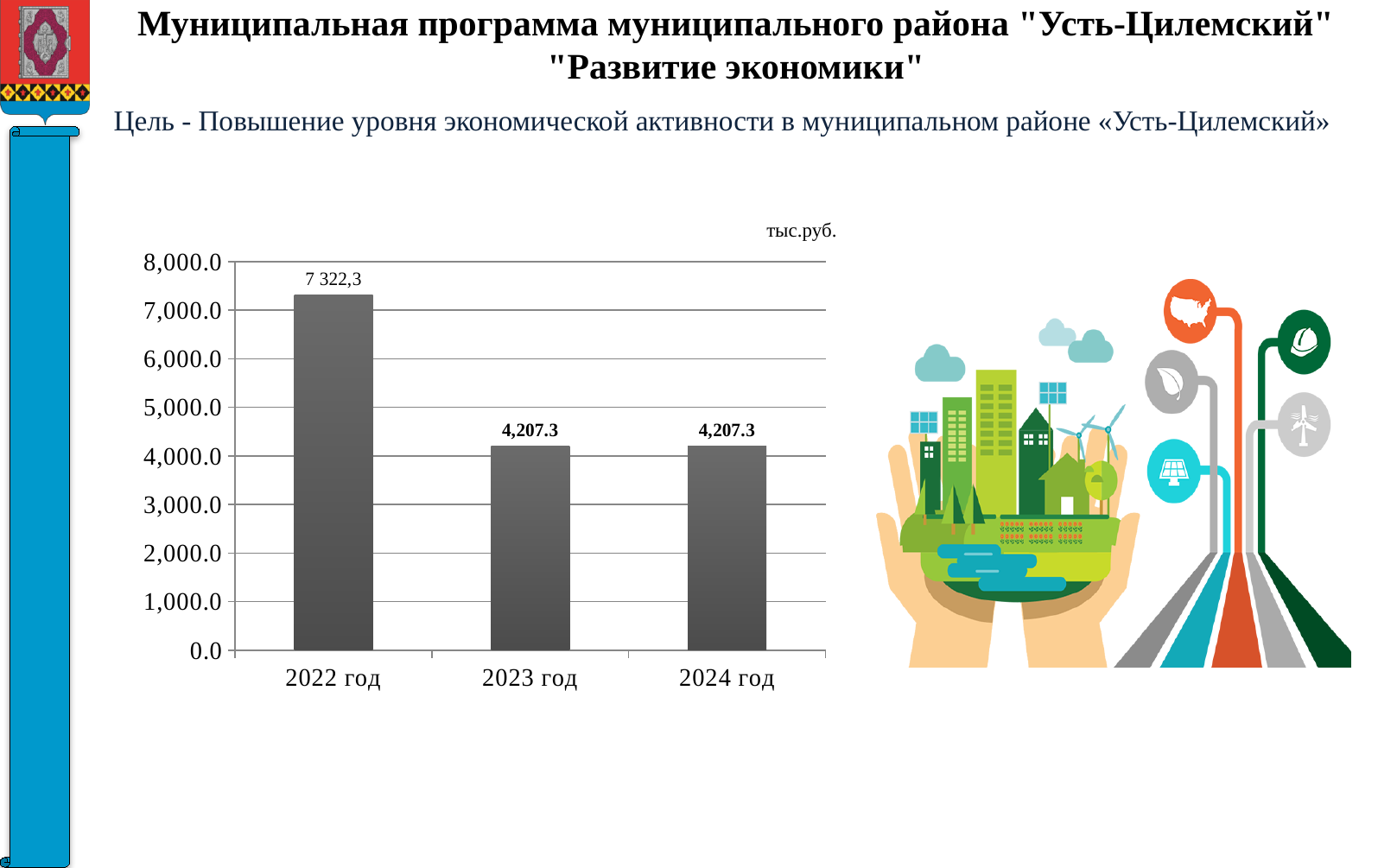
How do the values change from 2022 год to 2024 год? They fall from 2022 to 2023, then stay the same in 2024 What is the value for 2022 год? 7 322,3 What is the value for 2024 год? 4,207.3 Are the values for 2023 год and 2024 год the same or different? the same Which year has the highest value? 2022 год What unit is shown above the chart? тыс.руб. What is the value for 2023 год? 4,207.3 What kind of chart is shown on the slide? bar chart Is the value for 2022 год greater or less than 7,000.0? greater Is the value for 2023 год greater or less than 5,000.0? less Which is larger, the value for 2022 год or the value for 2023 год? 2022 год How many years are shown on the x axis? 3